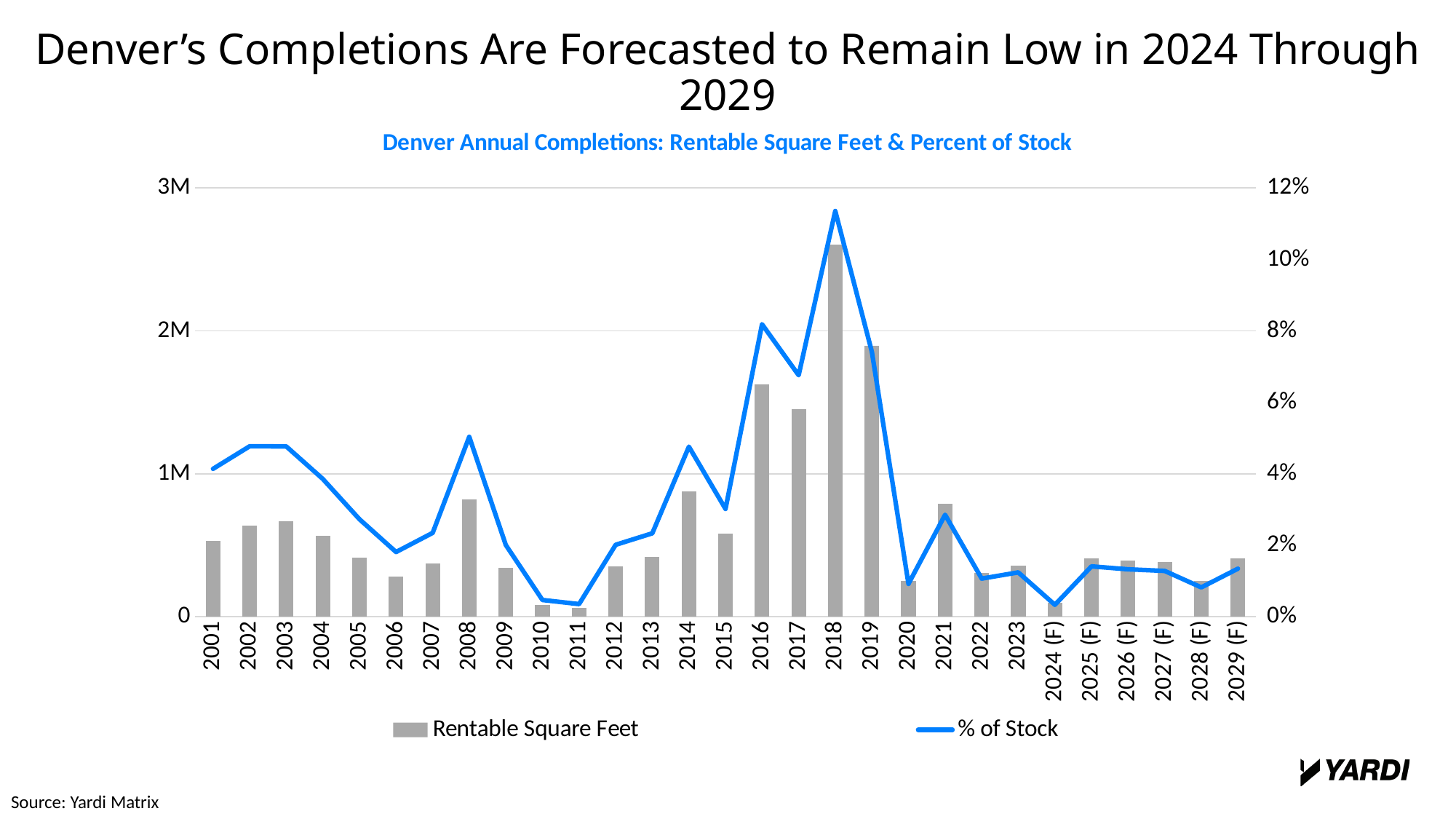
What kind of chart is this? Combination bar and line chart Which year has the highest Rentable Square Feet bar? 2018 What is the title of the chart? Denver Annual Completions: Rentable Square Feet & Percent of Stock How many series does the legend list? 2 Is the Rentable Square Feet value for 2019 greater or less than 2M? less Does the Rentable Square Feet value rise or fall from 2019 to 2020? fall Is the Rentable Square Feet value for 2018 greater or less than 2M? greater Is the % of Stock value for 2018 greater or less than 10%? greater In which year does the % of Stock line reach its peak? 2018 How many years are shown on the x axis? 29 Which year has the larger Rentable Square Feet bar, 2016 or 2017? 2016